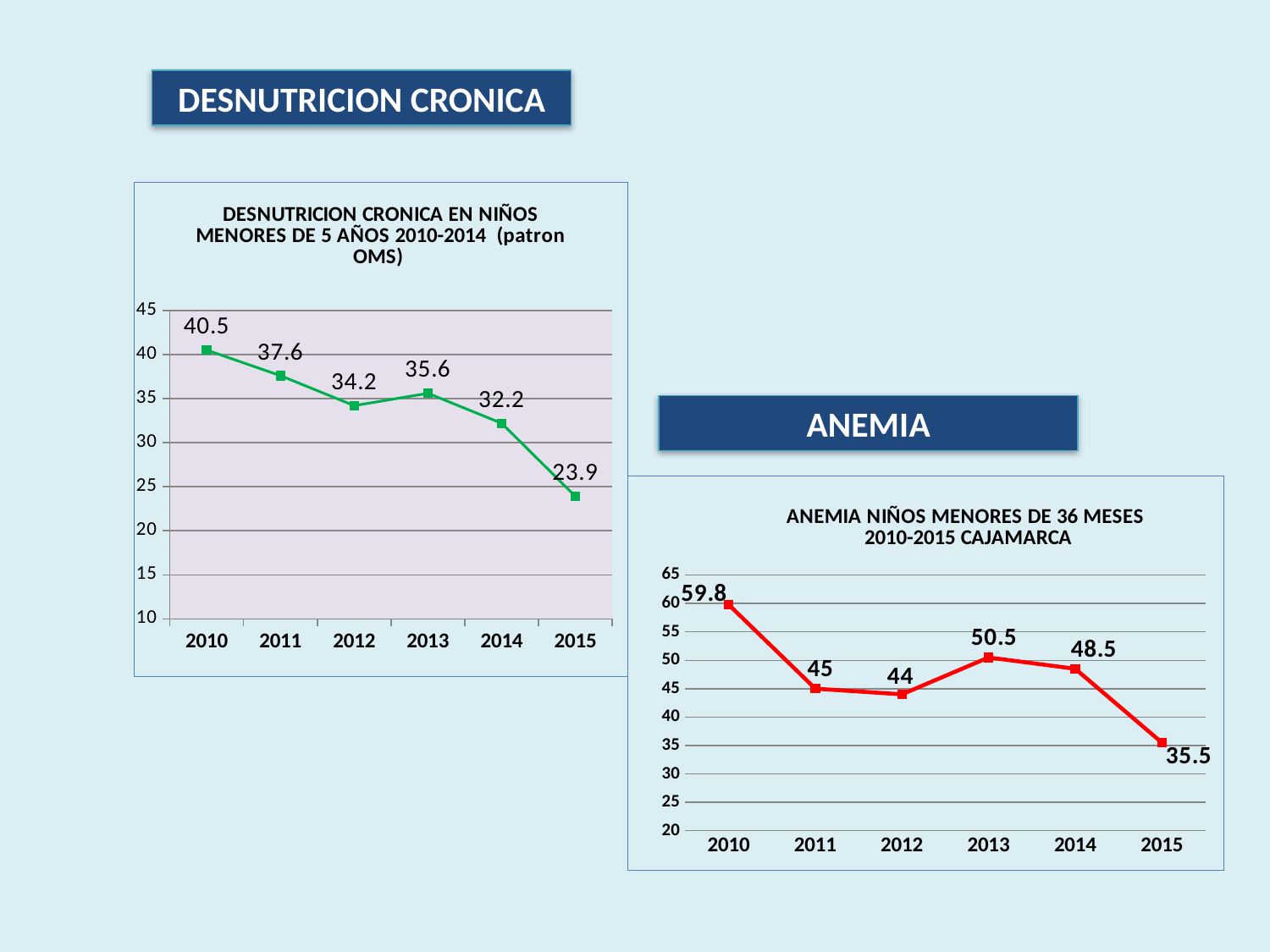
In the DESNUTRICION CRONICA chart, which year has the lowest value? 2015 In the ANEMIA chart, what is the difference between the 2014 and 2015 values? 13 In the ANEMIA chart, is the value for 2012 greater or less than 45? less In the DESNUTRICION CRONICA chart, how many years are plotted? 6 What type of chart is the ANEMIA chart? Line chart In the ANEMIA chart, do the values generally rise or fall from 2010 to 2015? Fall In the DESNUTRICION CRONICA chart, what is the difference between the 2010 and 2015 values? 16.6 In the DESNUTRICION CRONICA chart, what is the value for 2010? 40.5 In the ANEMIA chart, which year has the highest value? 2010 In the DESNUTRICION CRONICA chart, what is the value for 2015? 23.9 In the ANEMIA chart, what is the value for 2013? 50.5 In the DESNUTRICION CRONICA chart, which is larger, the value for 2012 or the value for 2013? 2013